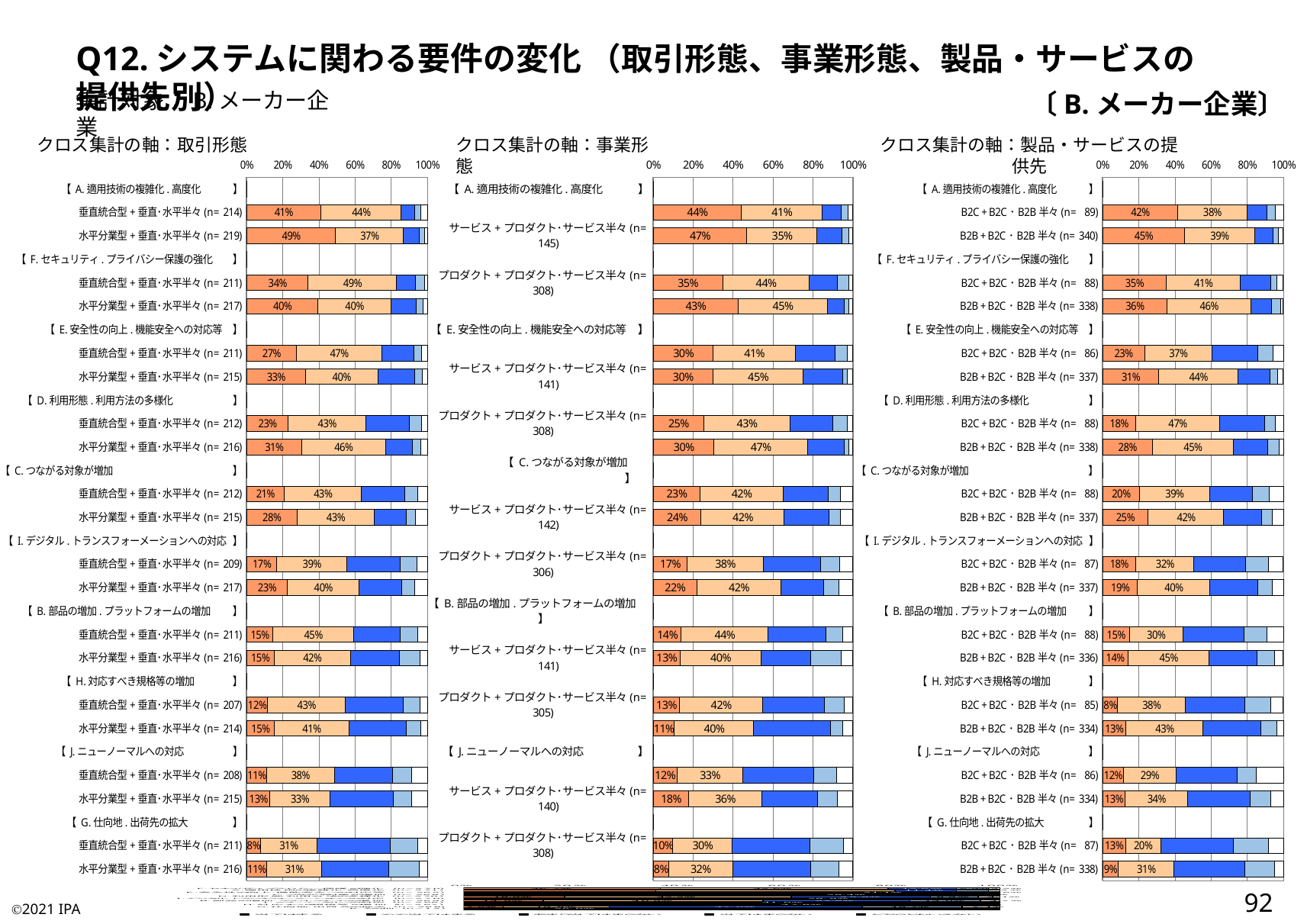
In the right chart (クロス集計の軸：製品・サービスの提供先), which row has the lowest first-segment value? B2C＋B2C・B2B半々 (n=85) under H. 対応すべき規格等の増加 (8%) How many bars are plotted in the left chart (クロス集計の軸：取引形態)? 20 How many charts are shown on the slide? 3 In the right chart (クロス集計の軸：製品・サービスの提供先), under B. 部品の増加・プラットフォームの増加, which row has the larger second-segment value: B2C＋B2C・B2B半々 (n=88) or B2B＋B2C・B2B半々 (n=336)? B2B＋B2C・B2B半々 (n=336), 45% In the left chart (クロス集計の軸：取引形態), what is the second (light orange) segment value for 水平分業型＋垂直・水平半々 (n=217) under F. セキュリティ・プライバシー保護の強化? 40% In the left chart (クロス集計の軸：取引形態), under A. 適用技術の複雑化・高度化, how many percentage points higher is the first-segment value for 水平分業型 (49%) than for 垂直統合型 (41%)? 8 percentage points In the right chart (クロス集計の軸：製品・サービスの提供先), what is the first segment value for B2C＋B2C・B2B半々 (n=88) under D. 利用形態・利用方法の多様化? 18% What kind of chart is used on this slide for the cross-tabulation by 取引形態 (left chart)? Stacked bar chart In the left chart (クロス集計の軸：取引形態), what is the first (dark orange) segment value for 垂直統合型＋垂直・水平半々 (n=214) under A. 適用技術の複雑化・高度化? 41% In the left chart (クロス集計の軸：取引形態), which row has the highest first-segment value? 水平分業型＋垂直・水平半々 (n=219) under A. 適用技術の複雑化・高度化 (49%) In the right chart (クロス集計の軸：製品・サービスの提供先), what is the second segment value for B2C＋B2C・B2B半々 (n=85) under H. 対応すべき規格等の増加? 38% In the left chart (クロス集計の軸：取引形態), what is the combined total of the first two segments for 垂直統合型＋垂直・水平半々 (n=214) under A. 適用技術の複雑化・高度化? 85%